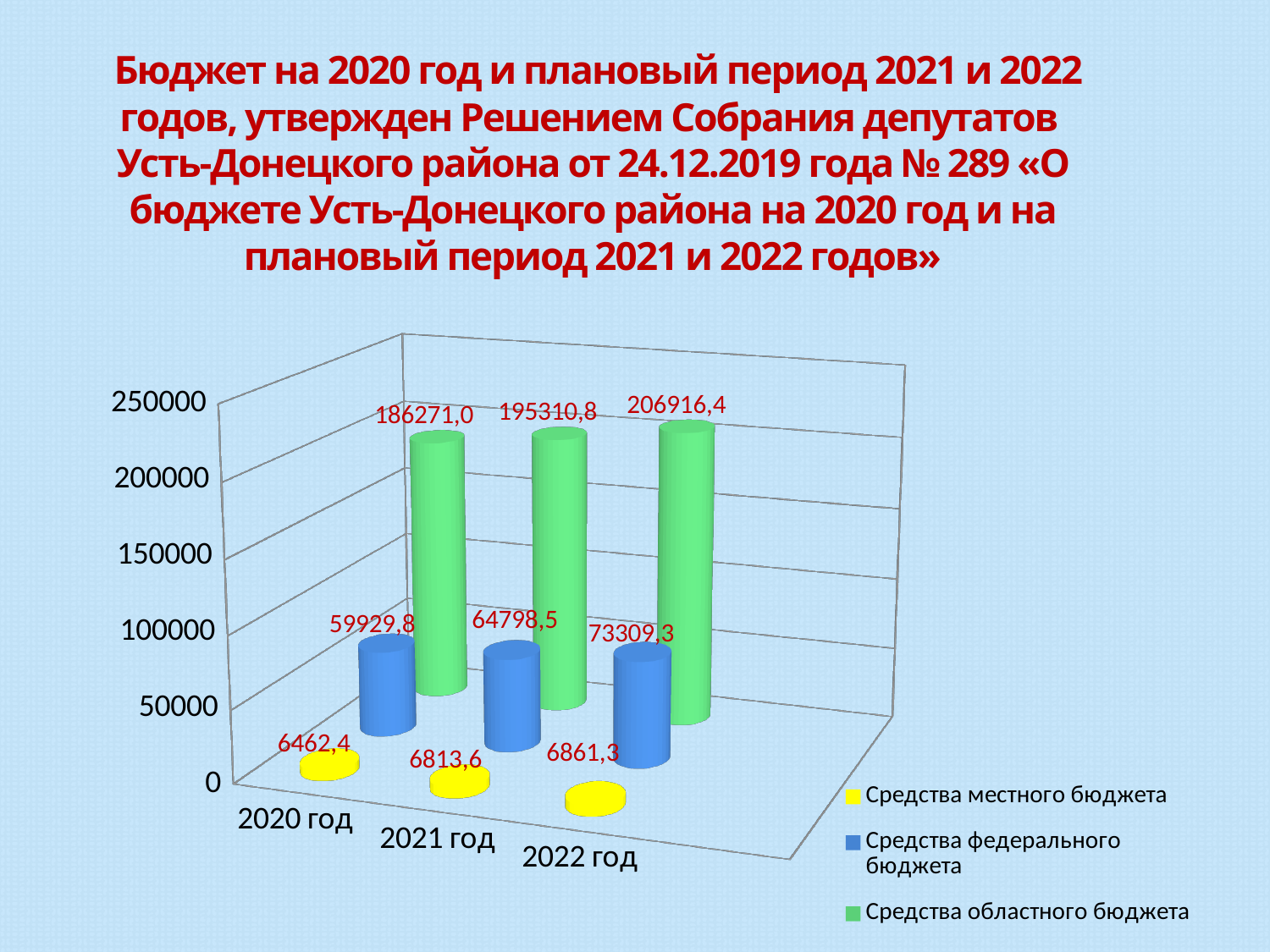
In which year is Средства федерального бюджета lowest? 2020 год How many years are shown on the x axis of the chart? 3 What is the difference between Средства федерального бюджета in 2022 год and in 2021 год? 8510,8 Which is larger: Средства федерального бюджета in 2021 год or Средства местного бюджета in 2022 год? Средства федерального бюджета in 2021 год How many series does the chart legend list? 3 In which year is Средства областного бюджета highest? 2022 год Do the values for Средства областного бюджета rise or fall from 2020 год to 2022 год? rise What is the value for Средства областного бюджета in 2020 год? 186271,0 What is the value for Средства федерального бюджета in 2022 год? 73309,3 Is the value for Средства областного бюджета in 2021 год greater or less than 150000? greater What is the value for Средства местного бюджета in 2021 год? 6813,6 What is the difference between Средства областного бюджета in 2022 год and in 2020 год? 20645,4